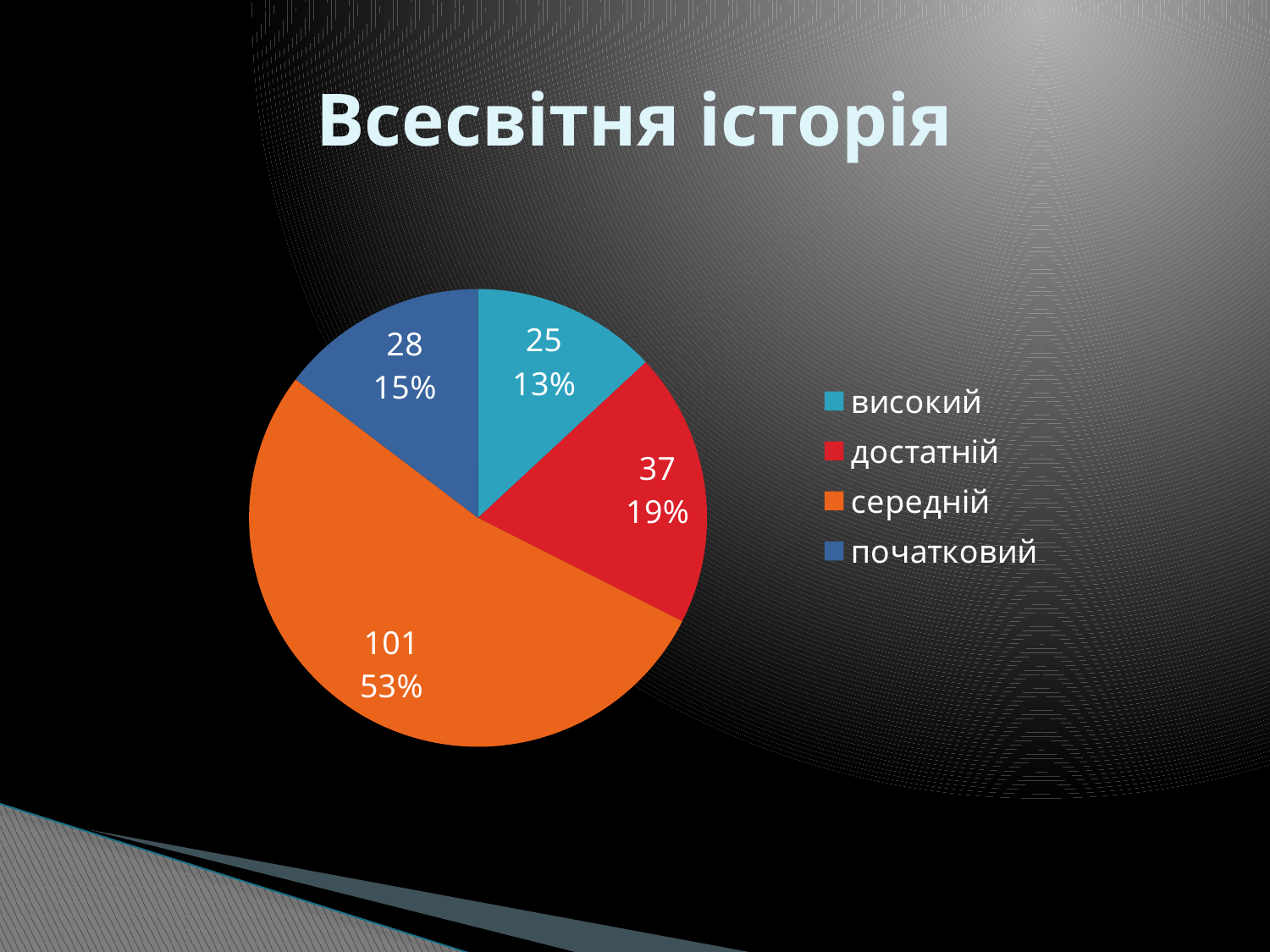
What colour is the slice for початковий? blue What percentage share does початковий have? 15% Which is larger, the value for початковий or the value for достатній? достатній What percentage share does достатній have? 19% What is the value for високий? 25 Which category has the largest slice? середній How many slices does the pie chart have? 4 Which category has the smallest slice? високий What is the difference between the values for середній and достатній? 64 What is the title of the chart? Всесвітня історія What kind of chart is shown on the slide? pie chart What is the value for середній? 101